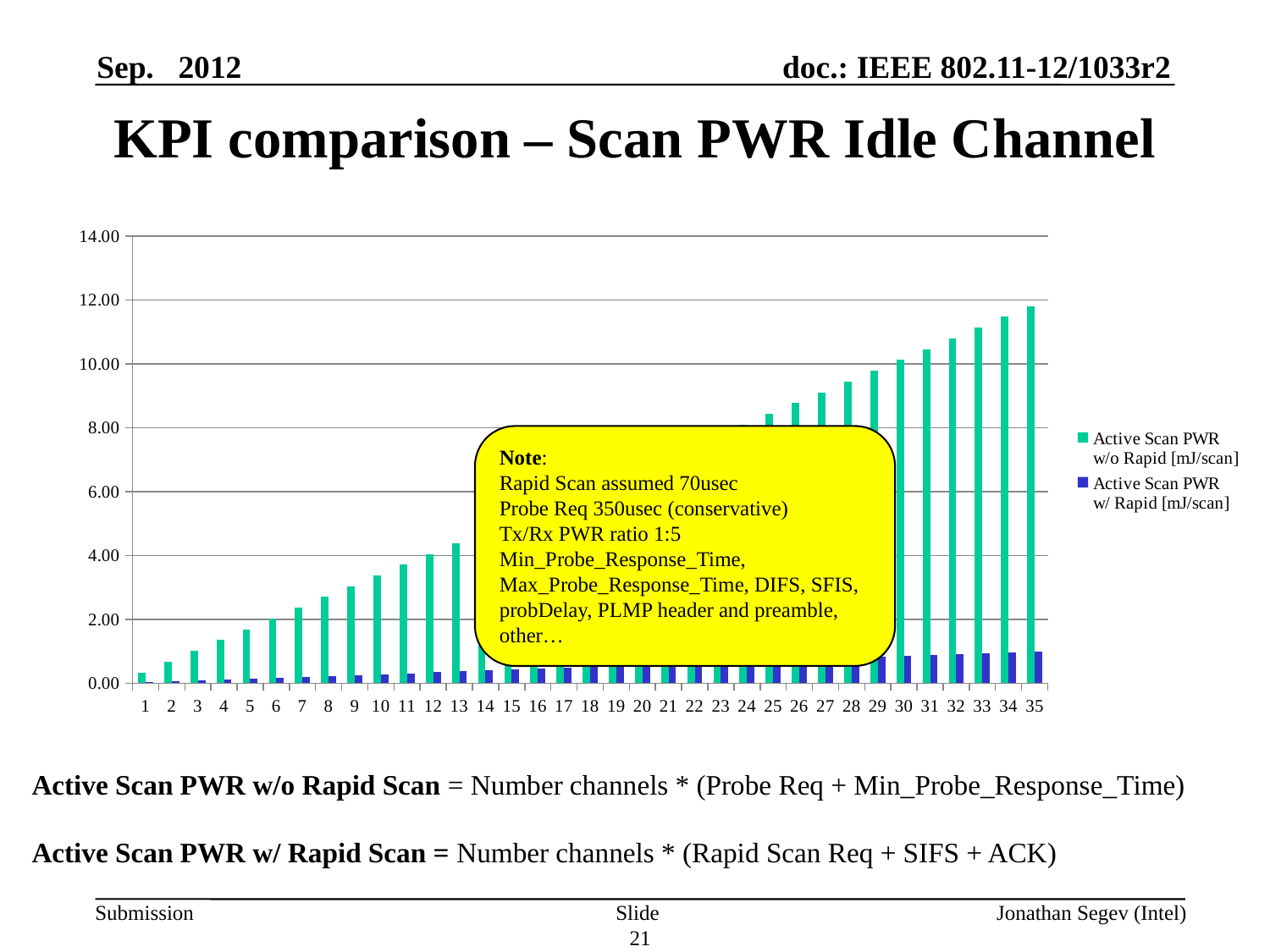
How many series does the chart's legend list? 2 How many categories are shown along the x axis of the chart? 35 What kind of chart is shown on the slide? bar chart Is the value for Active Scan PWR w/o Rapid [mJ/scan] at category 35 greater or less than 10.00? greater Is the value for Active Scan PWR w/o Rapid [mJ/scan] at category 10 greater or less than 4.00? less Which category has the lowest value for Active Scan PWR w/o Rapid [mJ/scan]? 1 Which category has the highest value for Active Scan PWR w/o Rapid [mJ/scan]? 35 Is the value for Active Scan PWR w/ Rapid [mJ/scan] at category 35 greater or less than 2.00? less Do the values for Active Scan PWR w/o Rapid [mJ/scan] rise or fall as the category number increases from 1 to 35? rise What colour are the bars for the Active Scan PWR w/ Rapid [mJ/scan] series? blue At category 35, which series has the larger value: Active Scan PWR w/o Rapid [mJ/scan] or Active Scan PWR w/ Rapid [mJ/scan]? Active Scan PWR w/o Rapid [mJ/scan]